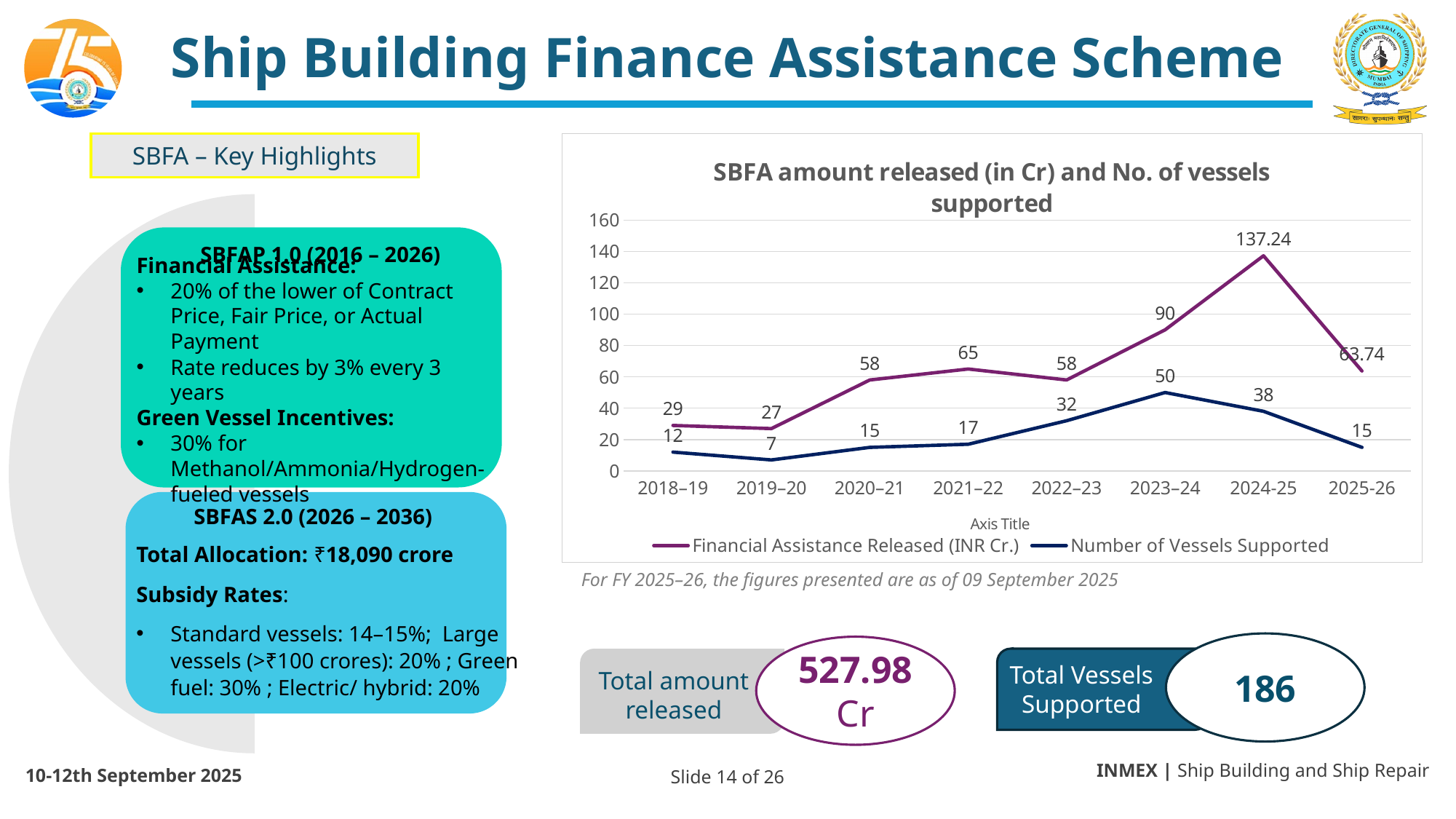
What was the Financial Assistance Released (INR Cr.) in 2025-26? 63.74 What type of chart is shown on the slide? line chart What is the difference between the Financial Assistance Released in 2023–24 and in 2022–23? 32 In which year was the Number of Vessels Supported the highest? 2023–24 How many fiscal years are plotted on the x axis of the chart? 8 In which year was the Number of Vessels Supported the lowest? 2019–20 What was the Number of Vessels Supported in 2022–23? 32 What was the Financial Assistance Released (INR Cr.) in 2024-25? 137.24 What is the title of the chart? SBFA amount released (in Cr) and No. of vessels supported Which is larger: the Number of Vessels Supported in 2021–22 or in 2024-25? 2024-25 Did the Financial Assistance Released rise or fall from 2024-25 to 2025-26? fall How many series does the chart legend list? 2